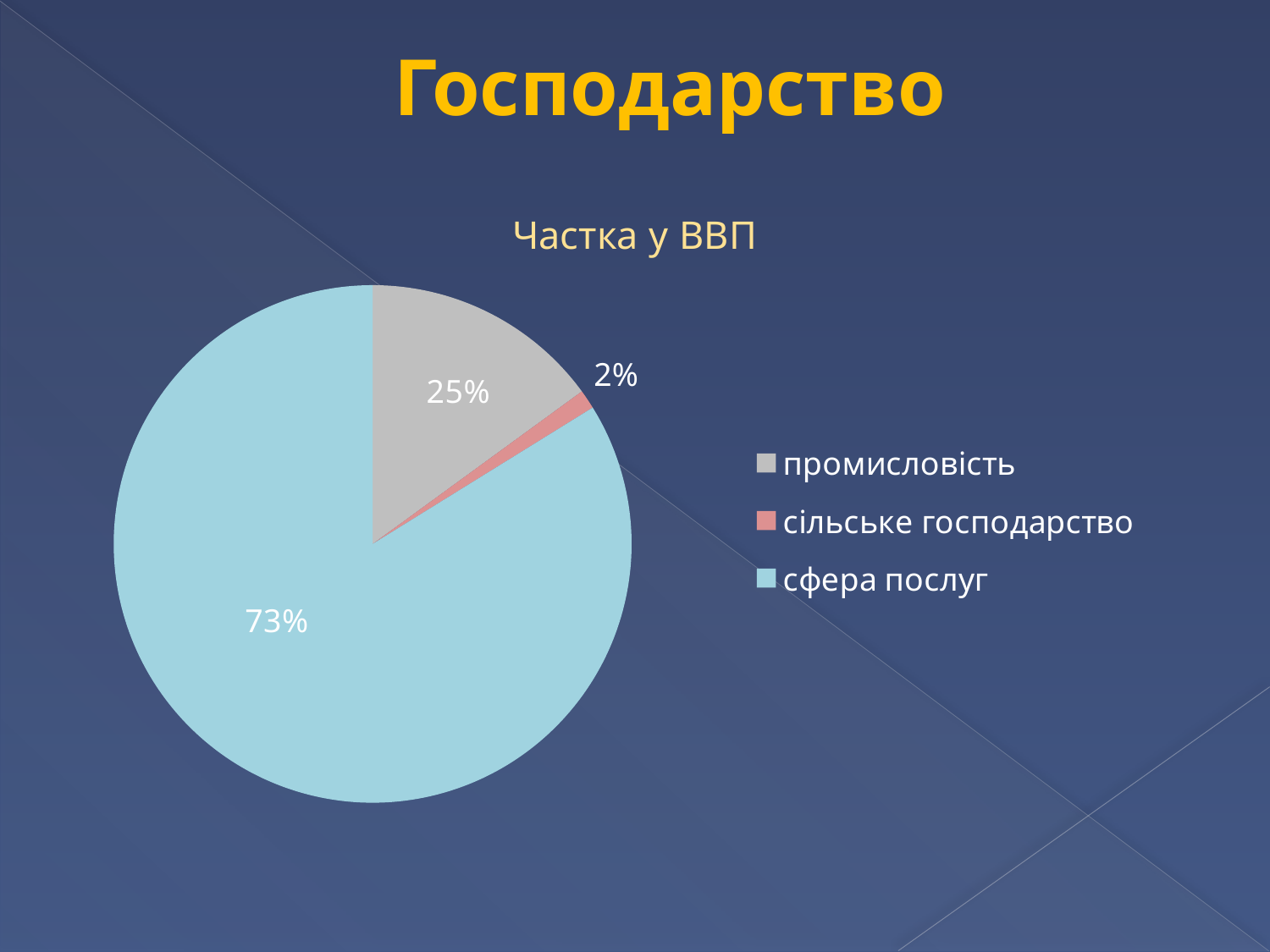
What is the difference between the shares of сфера послуг and промисловість? 48% What is the difference between the shares of промисловість and сільське господарство? 23% How many categories does the pie chart show? 3 What share of the pie does промисловість have? 25% Which category has the smallest share of the pie? сільське господарство Which colour represents сільське господарство in the legend? red (pink) Which is larger, the share of промисловість or the share of сільське господарство? промисловість Which category has the largest share of the pie? сфера послуг What is the title of the chart? Частка у ВВП What share of the pie does сільське господарство have? 2% What type of chart is shown on the slide? pie chart What share of the pie does сфера послуг have? 73%